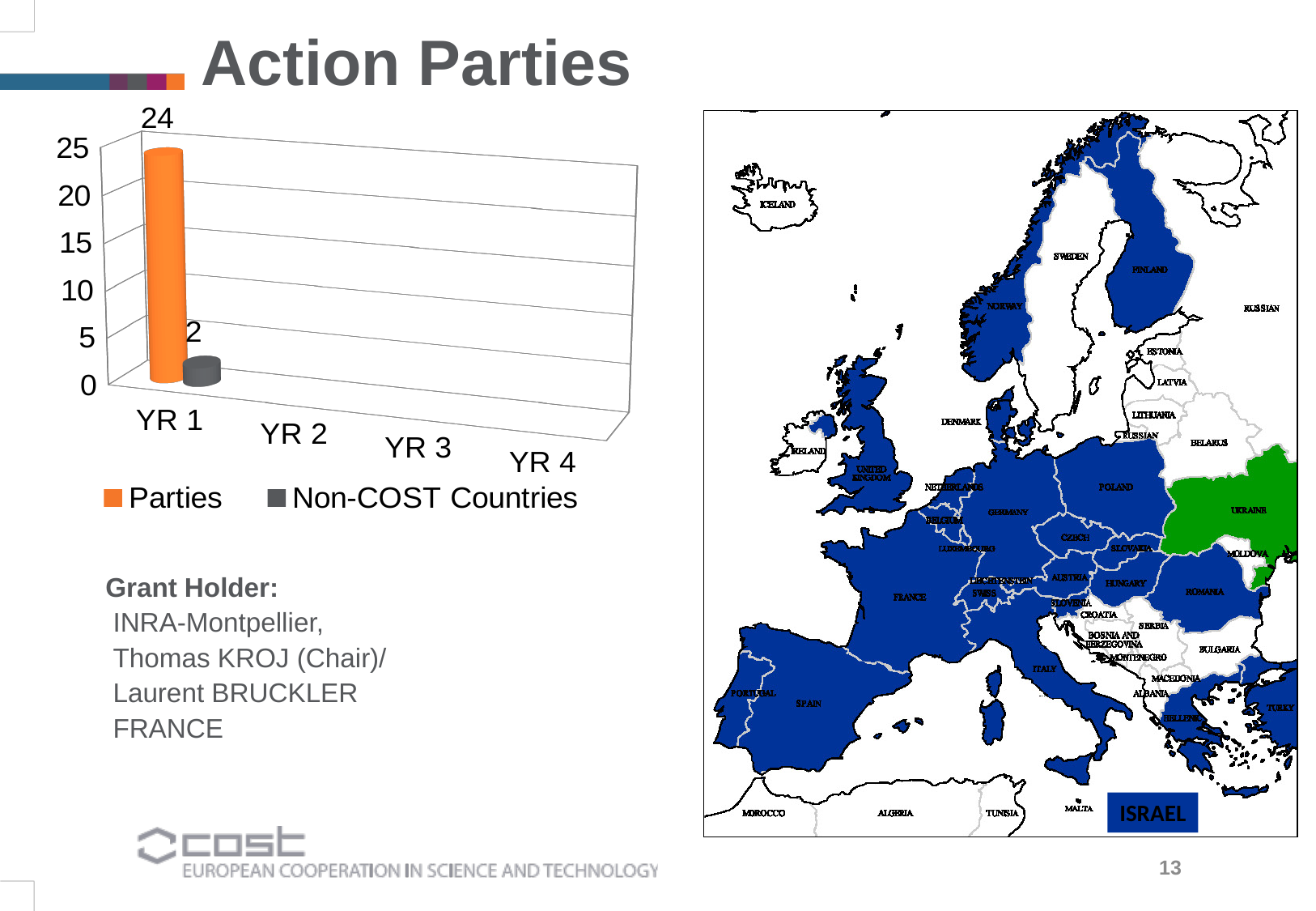
What is the value for Parties in YR 1? 24 What kind of chart is shown on the slide? bar chart What is the highest value shown on the chart's vertical axis? 25 How many categories are shown on the x axis of the chart? 4 What is the difference between Parties and Non-COST Countries in YR 1? 22 Is the value for Parties in YR 1 greater or less than 20? greater What colour represents the Parties series in the chart? orange What is the value for Non-COST Countries in YR 1? 2 Which is larger in YR 1, Parties or Non-COST Countries? Parties Which category on the x axis has bars plotted? YR 1 How many series does the chart legend list? 2 Is the value for Non-COST Countries in YR 1 greater or less than 5? less